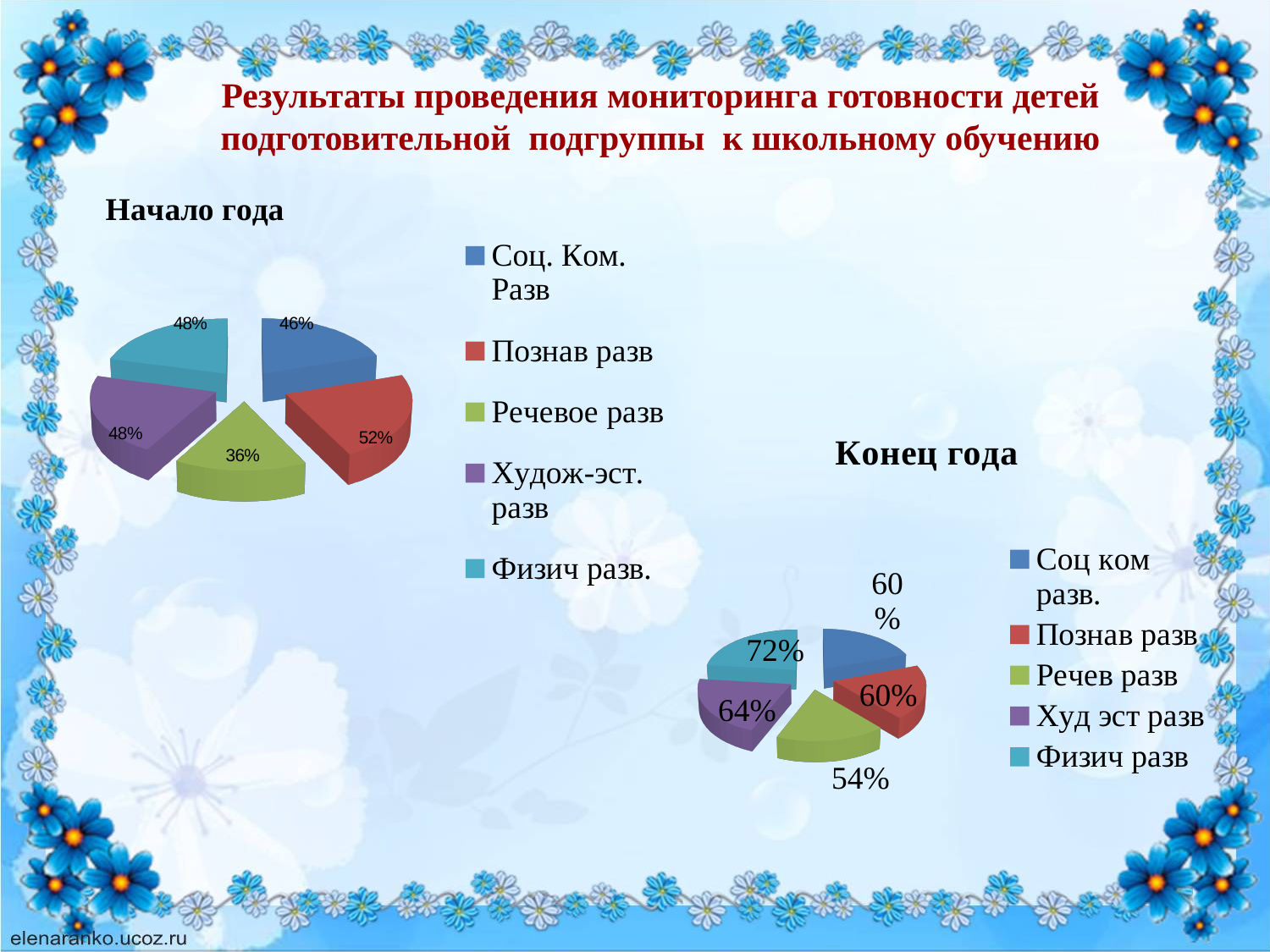
In the "Конец года" chart, what is the value for Физич разв? 72% In the "Конец года" chart, which category has the lowest value? Речев разв In the "Конец года" chart, what is the value for Речев разв? 54% In the "Начало года" chart, which category has the lowest value? Речевое разв In the "Конец года" chart, what is the difference between the values for Физич разв and Худ эст разв? 8% In the "Начало года" chart, which is larger: the value for Соц. Ком. Разв or the value for Речевое разв? Соц. Ком. Разв How many categories does the "Конец года" chart show? 5 In the "Начало года" chart, which category has the highest value? Познав разв In the "Начало года" chart, what is the value for Речевое разв? 36% What kind of chart is the "Начало года" chart? Pie chart In the "Начало года" chart, what is the value for Познав разв? 52% In the "Конец года" chart, which category has the highest value? Физич разв